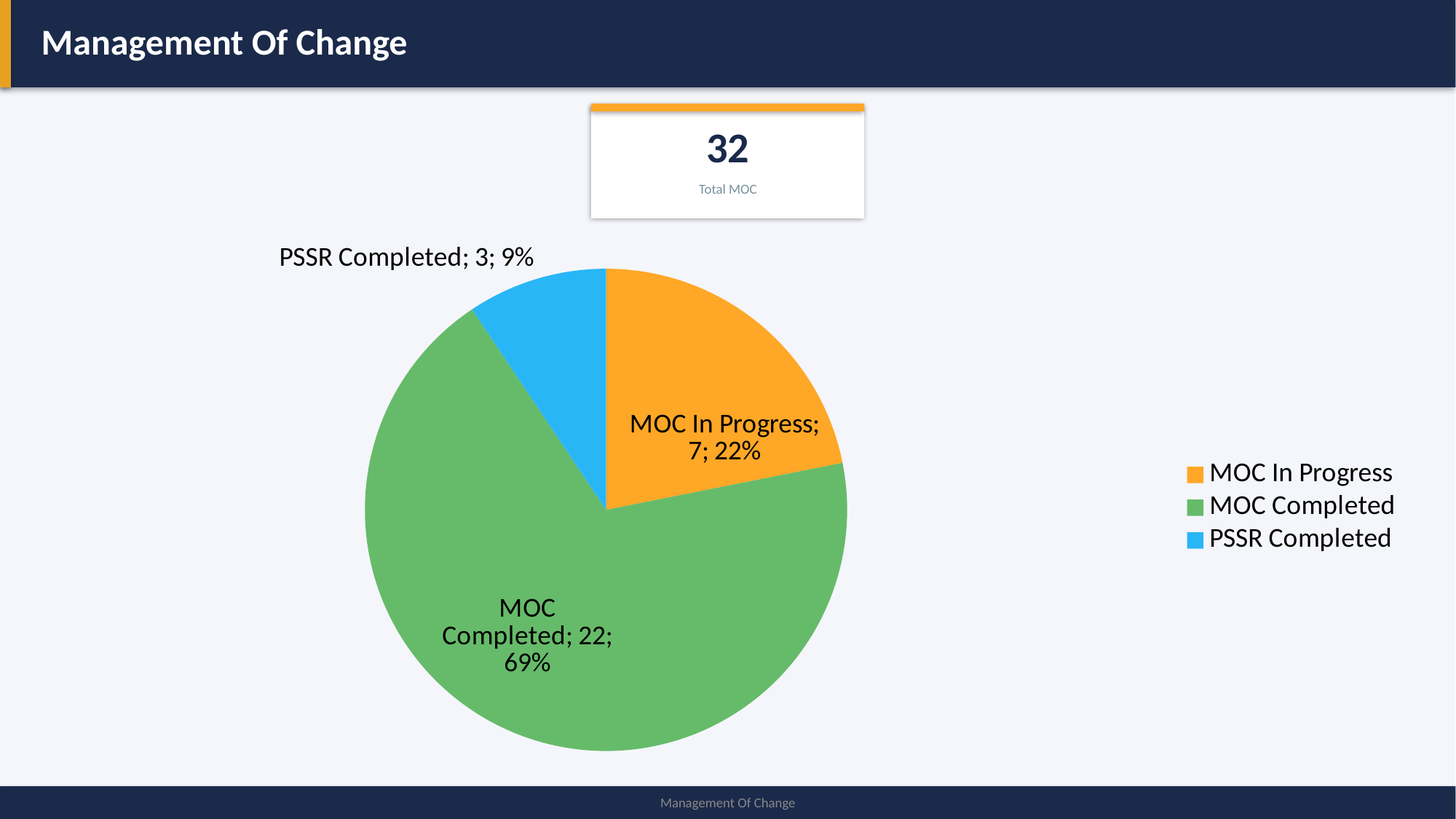
Which category has the smallest slice? PSSR Completed What is the value for MOC In Progress? 7 What is the value for PSSR Completed? 3 What share of the pie does MOC Completed represent? 69% What is the difference between the values for MOC Completed and MOC In Progress? 15 What is the value for MOC Completed? 22 How many slices does the pie chart have? 3 Which category has the largest slice? MOC Completed What share of the pie does PSSR Completed represent? 9% Which colour represents MOC In Progress in the pie chart? orange What kind of chart is shown on the slide? pie chart How many entries does the legend list? 3